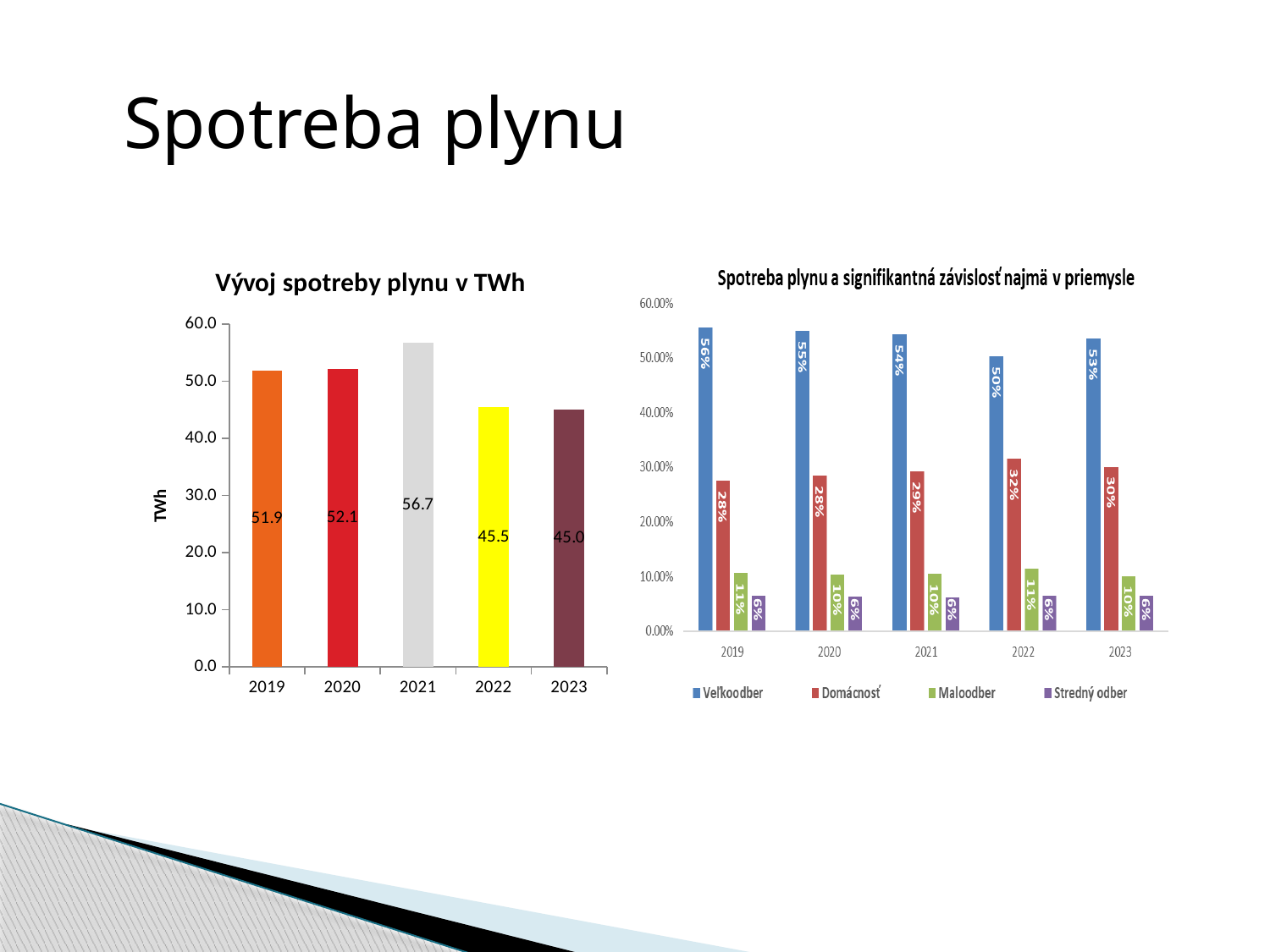
In the chart 'Vývoj spotreby plynu v TWh', what is the value for 2021? 56.7 In the chart 'Spotreba plynu a signifikantná závislosť najmä v priemysle', how many series does the legend list? 4 In the chart 'Vývoj spotreby plynu v TWh', what is the difference between the values for 2021 and 2023? 11.7 In the chart 'Spotreba plynu a signifikantná závislosť najmä v priemysle', what is the difference between Veľkoodber and Domácnosť in 2023? 23% In the chart 'Spotreba plynu a signifikantná závislosť najmä v priemysle', what is the value for Veľkoodber in 2019? 56% In the chart 'Spotreba plynu a signifikantná závislosť najmä v priemysle', which is larger in 2021: Maloodber or Stredný odber? Maloodber In the chart 'Spotreba plynu a signifikantná závislosť najmä v priemysle', what is the value for Domácnosť in 2022? 32% In the chart 'Vývoj spotreby plynu v TWh', how many years are shown on the x axis? 5 In the chart 'Vývoj spotreby plynu v TWh', what kind of chart is it? bar chart In the chart 'Spotreba plynu a signifikantná závislosť najmä v priemysle', does the Veľkoodber value rise or fall from 2019 to 2023? fall In the chart 'Vývoj spotreby plynu v TWh', which year has the highest value? 2021 In the chart 'Vývoj spotreby plynu v TWh', which year has the lowest value? 2023